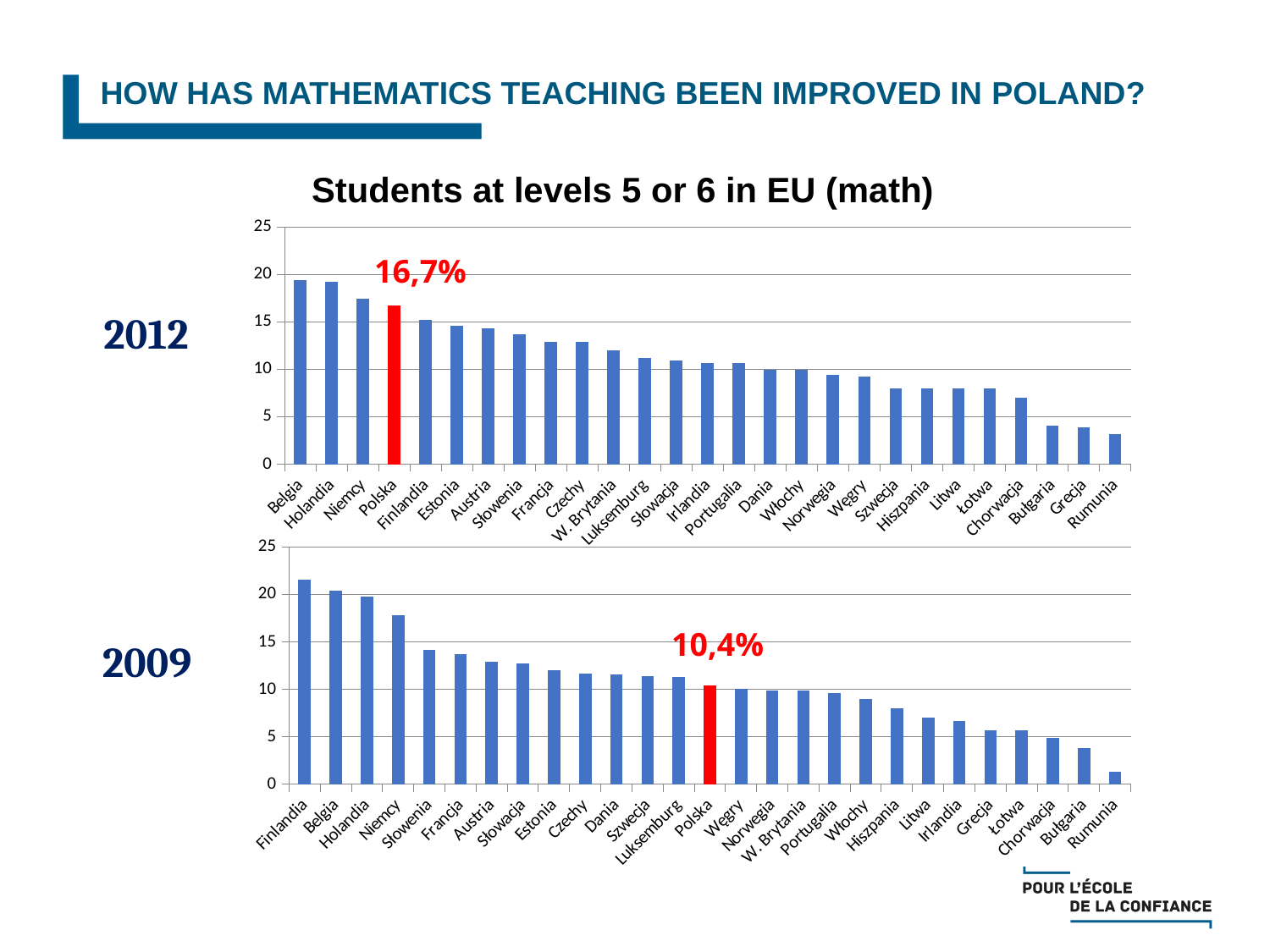
In the 2012 chart, is the value for Niemcy greater or less than 15? greater Is Polska's value larger in the 2012 chart or in the 2009 chart? 2012 How many countries are shown in the 2012 chart? 27 In the 2012 chart, what is the value shown for Polska? 16,7% In the 2009 chart, is the value for Finlandia greater or less than 20? greater In the 2012 chart, is the value for Chorwacja greater or less than 10? less In the 2009 chart, which country has the highest value? Finlandia In the 2012 chart, which country has the lowest value? Rumunia What type of chart is used for the 2009 data? Bar chart In the 2009 chart, which country has the lowest value? Rumunia By how many percentage points did Polska's value rise from the 2009 chart to the 2012 chart? 6,3 In the 2009 chart, what is the value shown for Polska? 10,4%